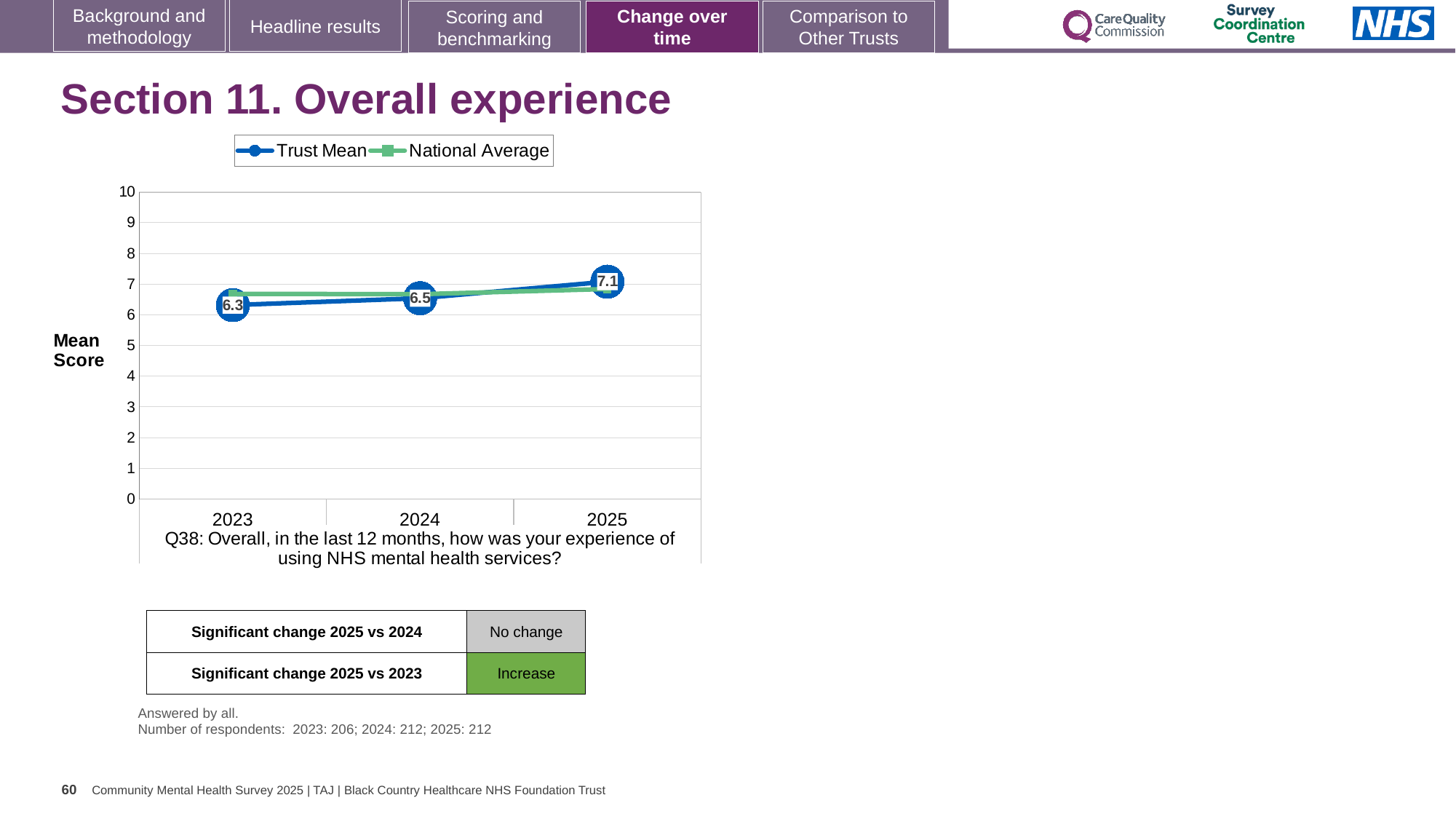
What is the Trust Mean value for 2023? 6.3 Does the Trust Mean rise or fall from 2023 to 2025? rise How many series does the legend list? 2 Which year has the larger Trust Mean, 2024 or 2025? 2025 What kind of chart is shown on the slide? line chart In which year is the Trust Mean lowest? 2023 What is the Trust Mean value for 2024? 6.5 What is the difference between the Trust Mean in 2025 and in 2023? 0.8 What is the Trust Mean value for 2025? 7.1 Is the National Average value for 2023 greater or less than 5? greater In which year is the Trust Mean highest? 2025 How many years are plotted on the x axis? 3